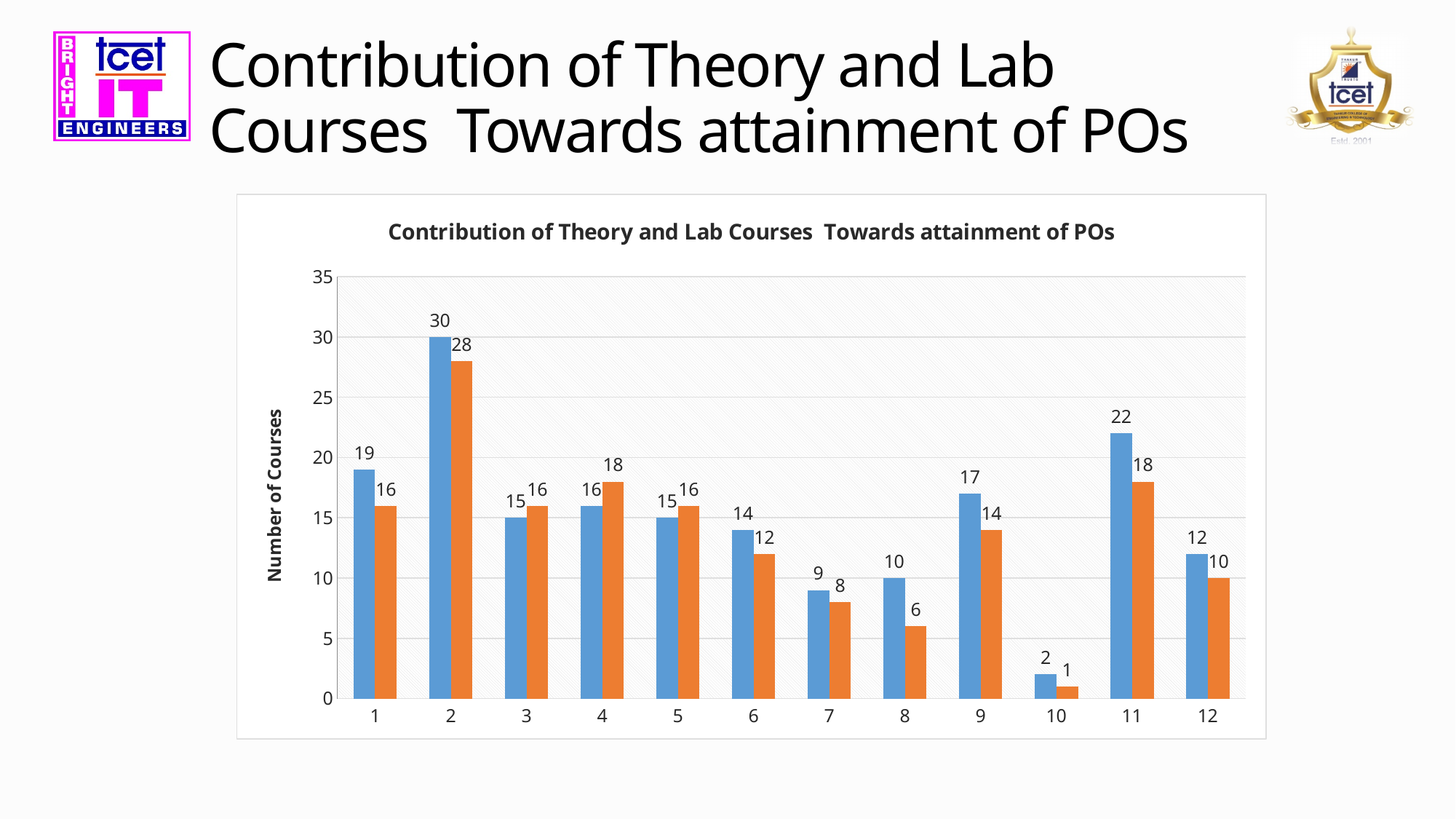
What kind of chart is shown on the slide? bar chart What is the difference between the blue and orange bars for category 9? 3 What is the label of the vertical axis? Number of Courses Is the value of the blue bar for category 11 greater or less than 20? greater What is the value of the blue bar for category 2? 30 Which category has the lowest orange bar? 10 For category 4, which bar is larger, blue or orange? orange How many categories are shown on the x axis? 12 What is the difference between the blue bar for category 2 and the blue bar for category 11? 8 What is the value of the orange bar for category 8? 6 Which category has the highest blue bar? 2 What is the value of the orange bar for category 11? 18